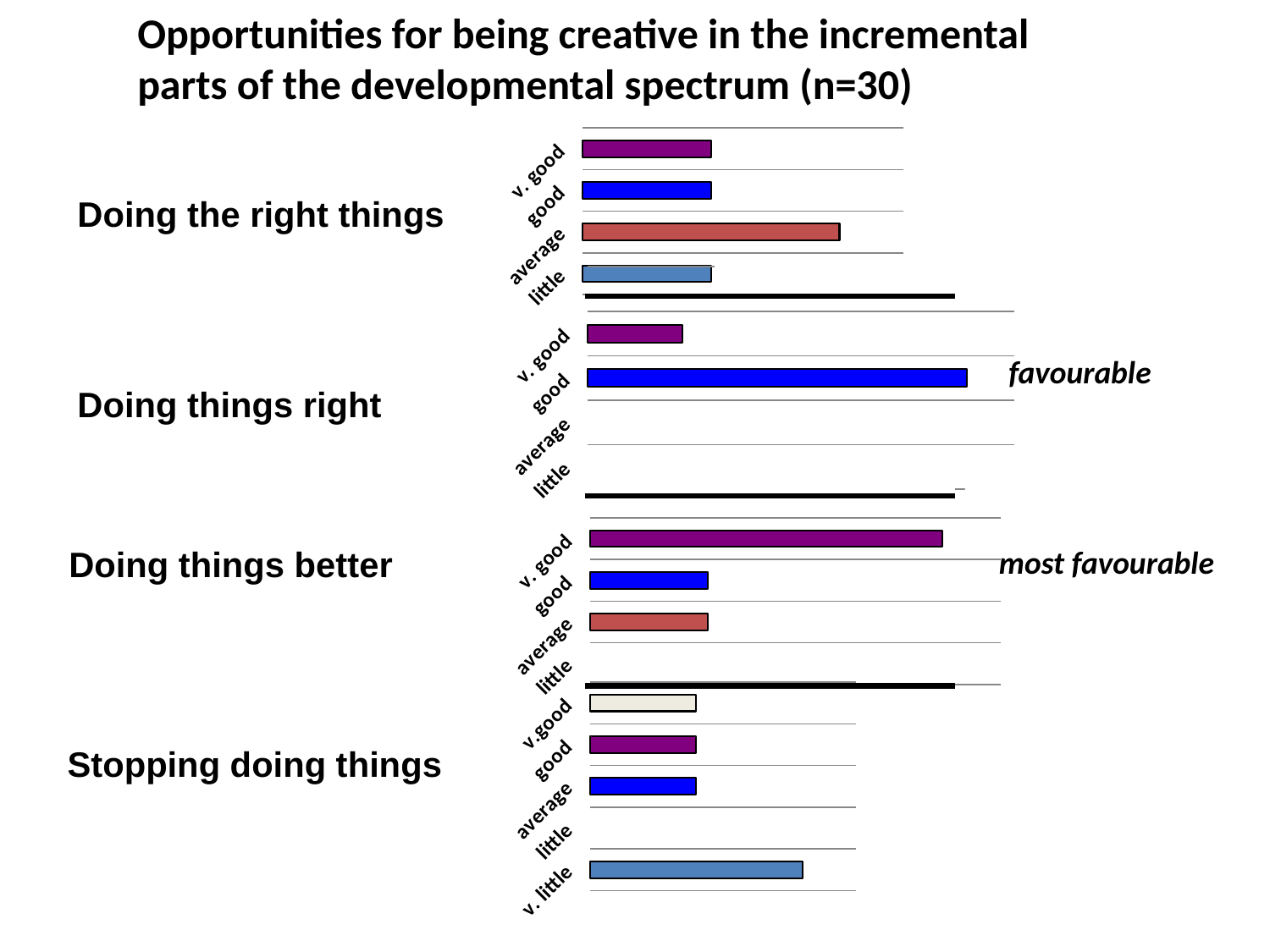
In the "Doing things better" chart, which is larger, the bar for v. good or the bar for average? v. good In the "Doing things better" chart, which category has the longest bar? v. good In the "Stopping doing things" chart, which category has the longest bar? v. little Which chart on the slide is annotated as "most favourable"? Doing things better In the "Doing things right" chart, which category has the longest bar? good In the "Stopping doing things" chart, how many categories are listed on the axis? 5 In the "Doing things right" chart, which is larger, the bar for v. good or the bar for good? good In the "Doing the right things" chart, which is larger, the bar for average or the bar for good? average In the "Doing the right things" chart, what kind of chart is shown? bar chart In the "Doing the right things" chart, how many categories are listed on the axis? 4 How many separate bar charts are shown on the slide? 4